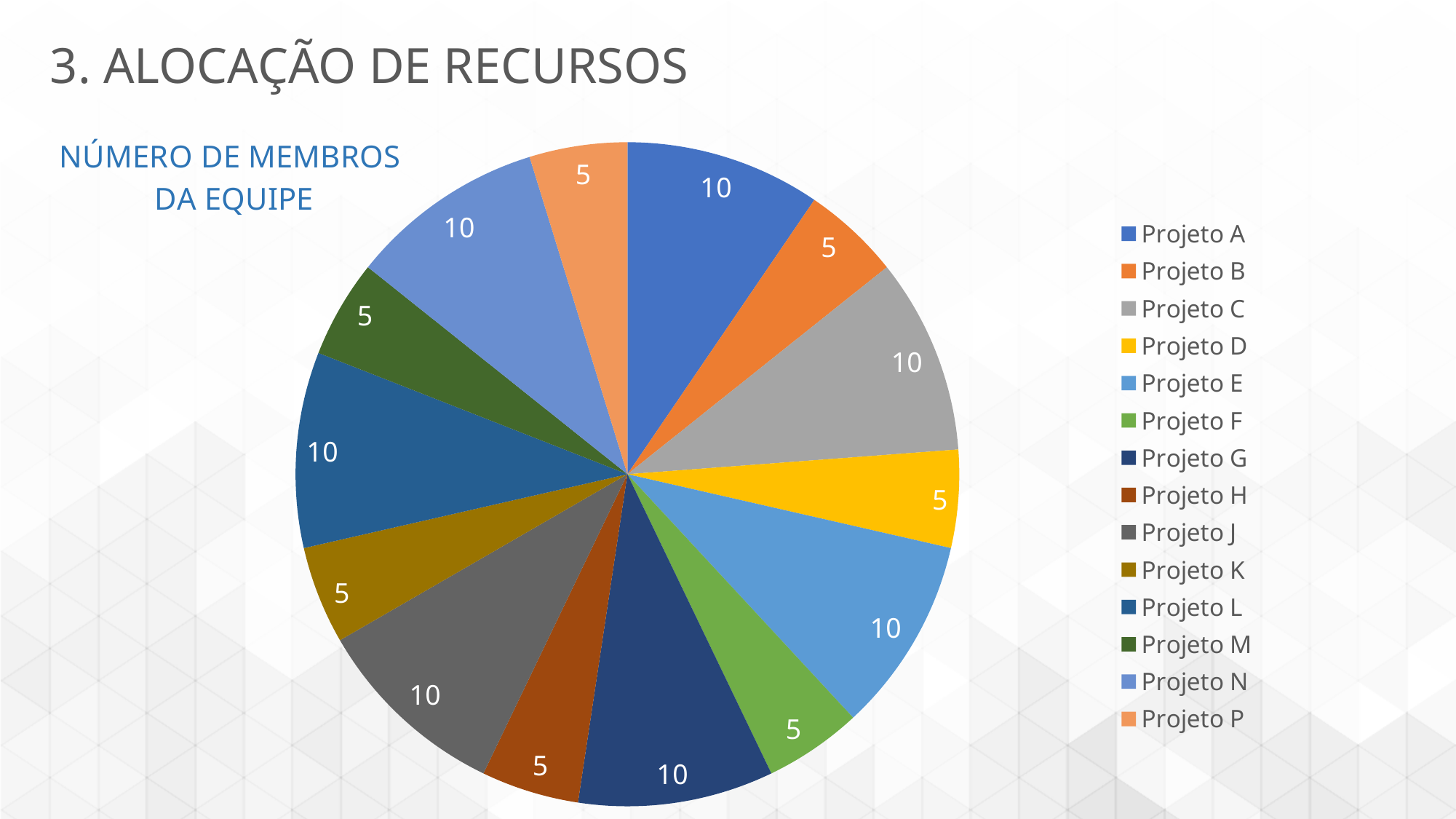
How many slices does the pie chart have? 14 What is the value for Projeto A? 10 What is the title of the chart? NÚMERO DE MEMBROS DA EQUIPE What is the value for Projeto D? 5 What is the difference between the value for Projeto G and the value for Projeto H? 5 Which is larger, the value for Projeto C or the value for Projeto D? Projeto C What is the value for Projeto P? 5 What is the value for Projeto L? 10 What is the value for Projeto B? 5 What type of chart is shown on the slide? pie chart How many entries does the legend list? 14 What is the total of all the slice values in the pie chart? 105